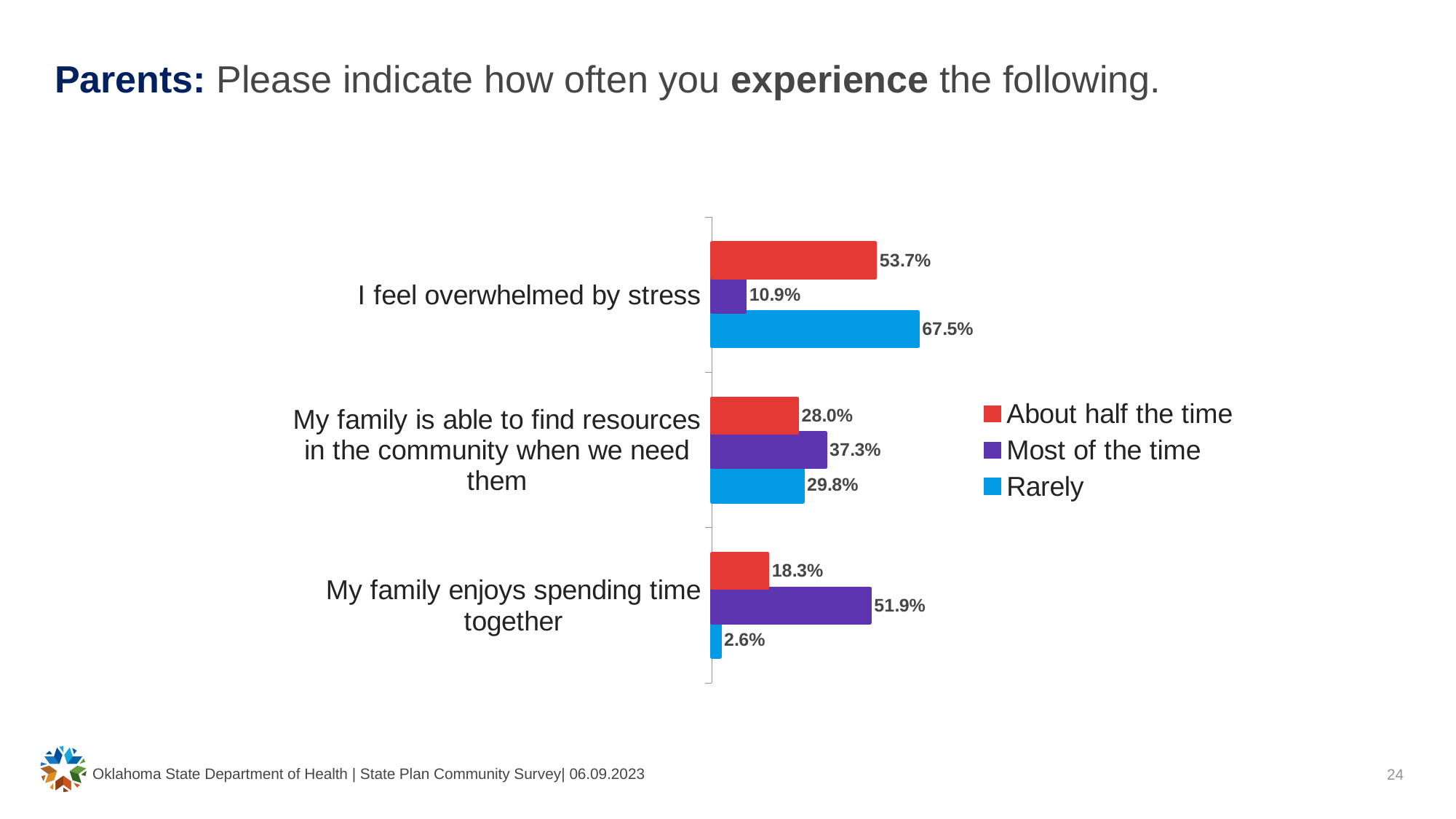
What is the "Most of the time" value for "My family enjoys spending time together"? 51.9% What percentage of parents said they feel overwhelmed by stress "Rarely"? 67.5% How many series does the legend list? 3 Which legend entry is shown in blue? Rarely What is the smallest value shown on the chart? 2.6% What type of chart is shown on the slide? Bar chart How many categories (statements) are shown on the chart? 3 Which category has the lowest "Most of the time" value? I feel overwhelmed by stress What is the difference between the "Rarely" and "Most of the time" values for "I feel overwhelmed by stress"? 56.6% For "My family is able to find resources in the community when we need them", which is larger: "Most of the time" or "Rarely"? Most of the time Which category has the highest "Rarely" value? I feel overwhelmed by stress What is the "About half the time" value for "My family is able to find resources in the community when we need them"? 28.0%